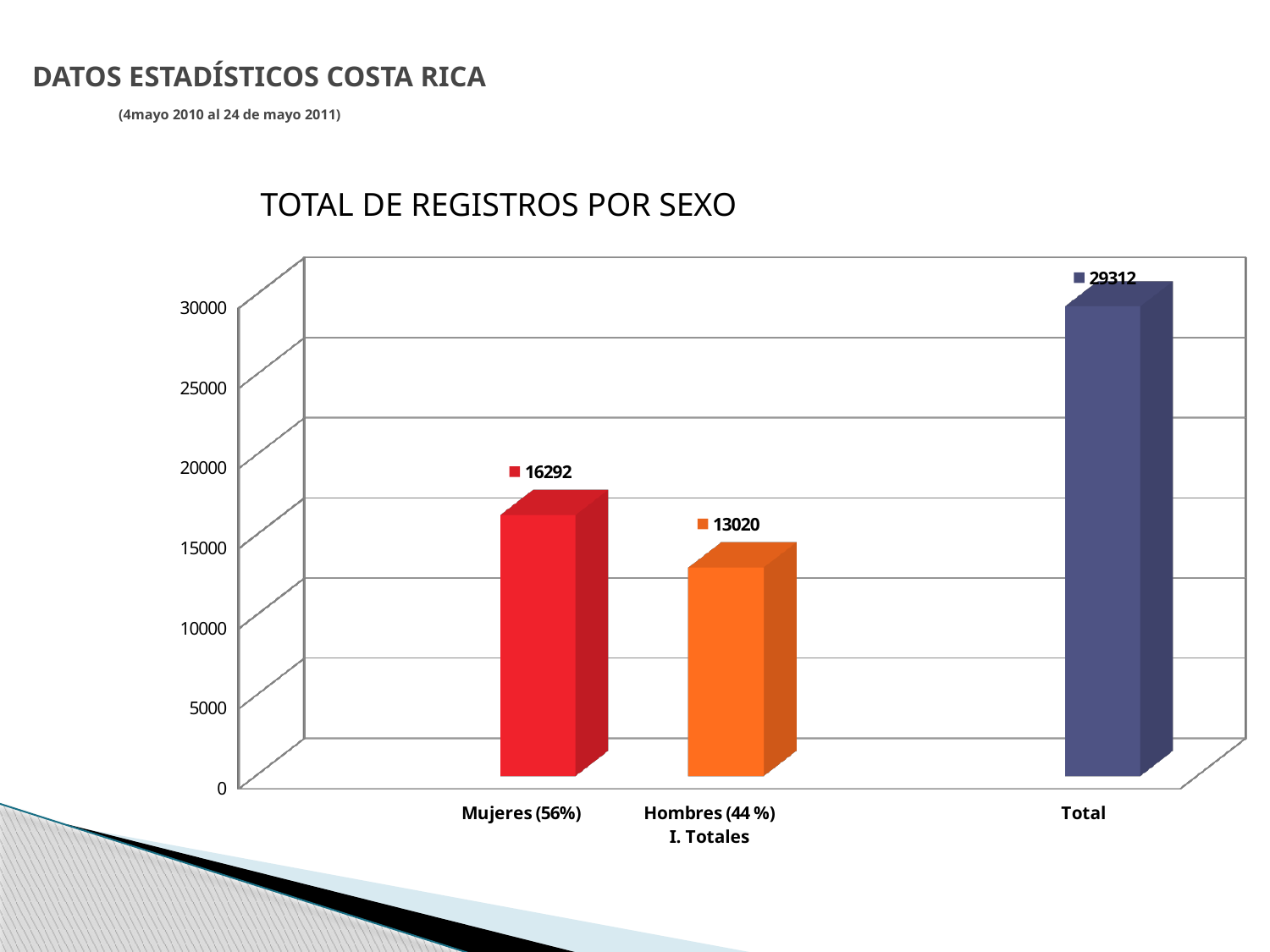
What is the title of the chart? TOTAL DE REGISTROS POR SEXO What is the value for Total? 29312 What is the x-axis title of the chart? I. Totales Which category has the lowest value? Hombres (44 %) How many categories are shown on the x axis? 3 What is the value for Mujeres (56%)? 16292 What kind of chart is shown on the slide? bar chart Which is larger, the value for Mujeres (56%) or the value for Hombres (44 %)? Mujeres (56%) Which category has the highest value? Total Is the value for Hombres (44 %) greater or less than 15000? less What is the value for Hombres (44 %)? 13020 What is the difference between the values for Mujeres (56%) and Hombres (44 %)? 3272